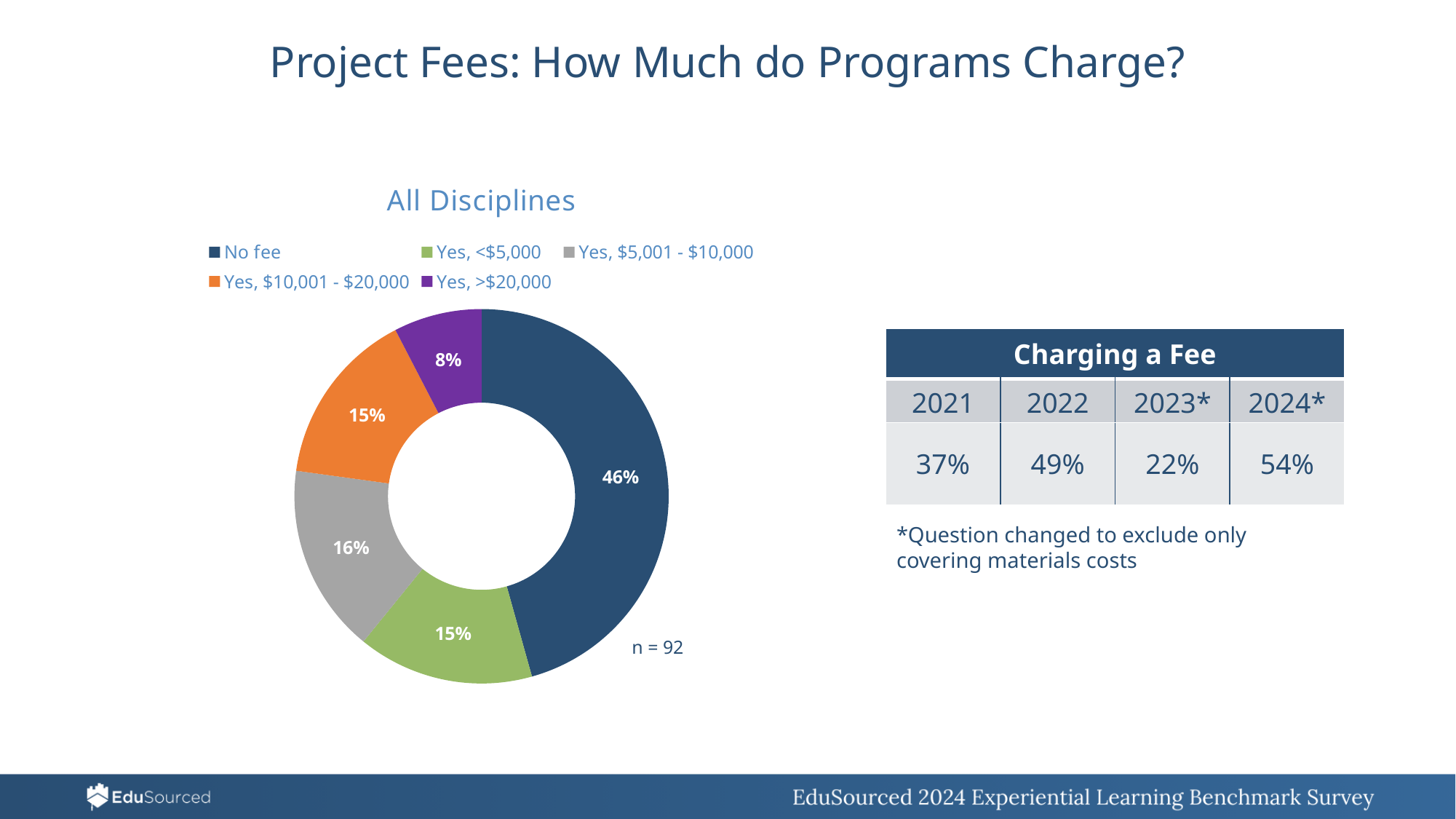
What kind of chart is shown on the slide? Donut (pie) chart Which category has the largest slice in the chart? No fee Which is larger in the chart: "Yes, $5,001 - $10,000" or "Yes, >$20,000"? Yes, $5,001 - $10,000 Which category has the smallest slice in the chart? Yes, >$20,000 What share of the chart is labelled "Yes, <$5,000"? 15% What share of the chart is labelled "No fee"? 46% What share of the chart is labelled "Yes, >$20,000"? 8% What share of the chart is labelled "Yes, $5,001 - $10,000"? 16% How many categories does the chart's legend list? 5 What is the title of the chart? All Disciplines What sample size (n) is shown next to the chart? n = 92 What is the difference between the "No fee" share and the "Yes, $5,001 - $10,000" share? 30 percentage points